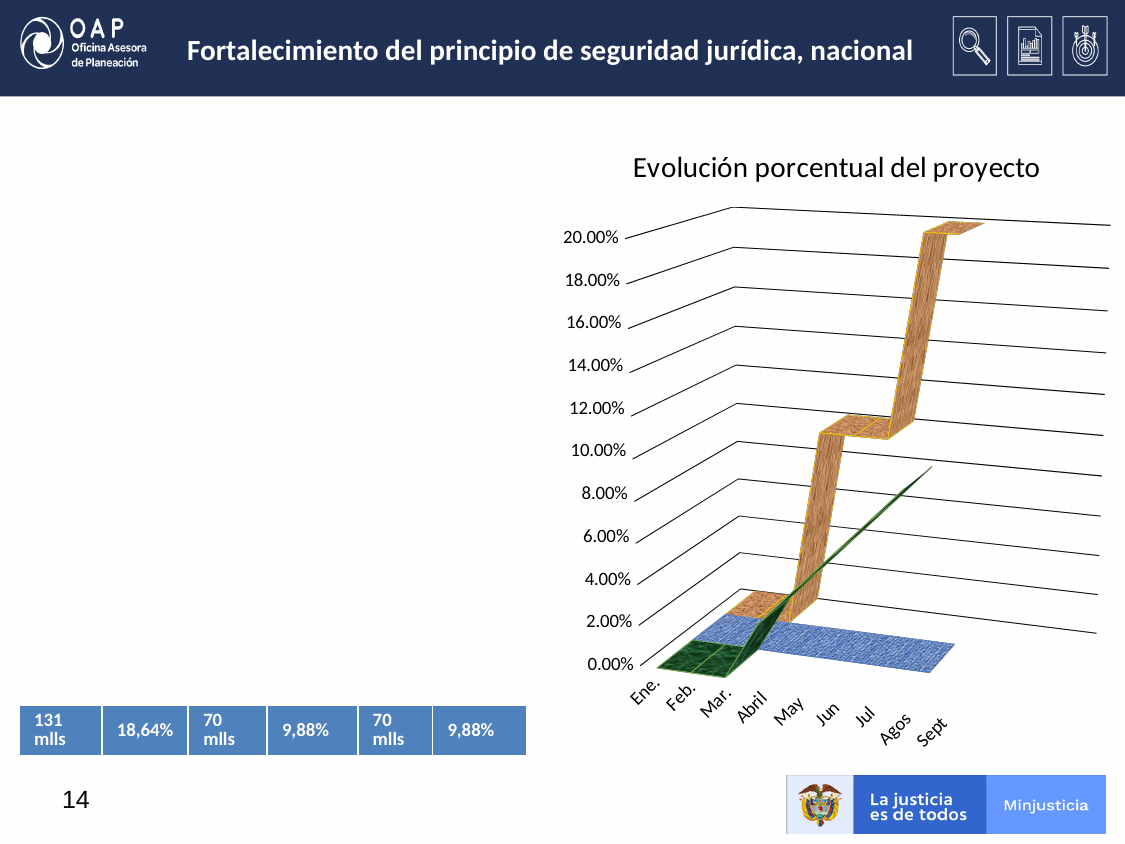
Does the orange series rise or fall from Ene. to Sept? rises Is the value of the orange series for Ene. greater or less than 6.00%? less What is the last category on the x axis of the chart? Sept What kind of chart is shown on the slide? line chart What is the highest value shown on the y axis of the chart? 20.00% What is the title of the chart on the slide? Evolución porcentual del proyecto What is the first category on the x axis of the chart? Ene. How many categories are shown along the x axis of the chart? 9